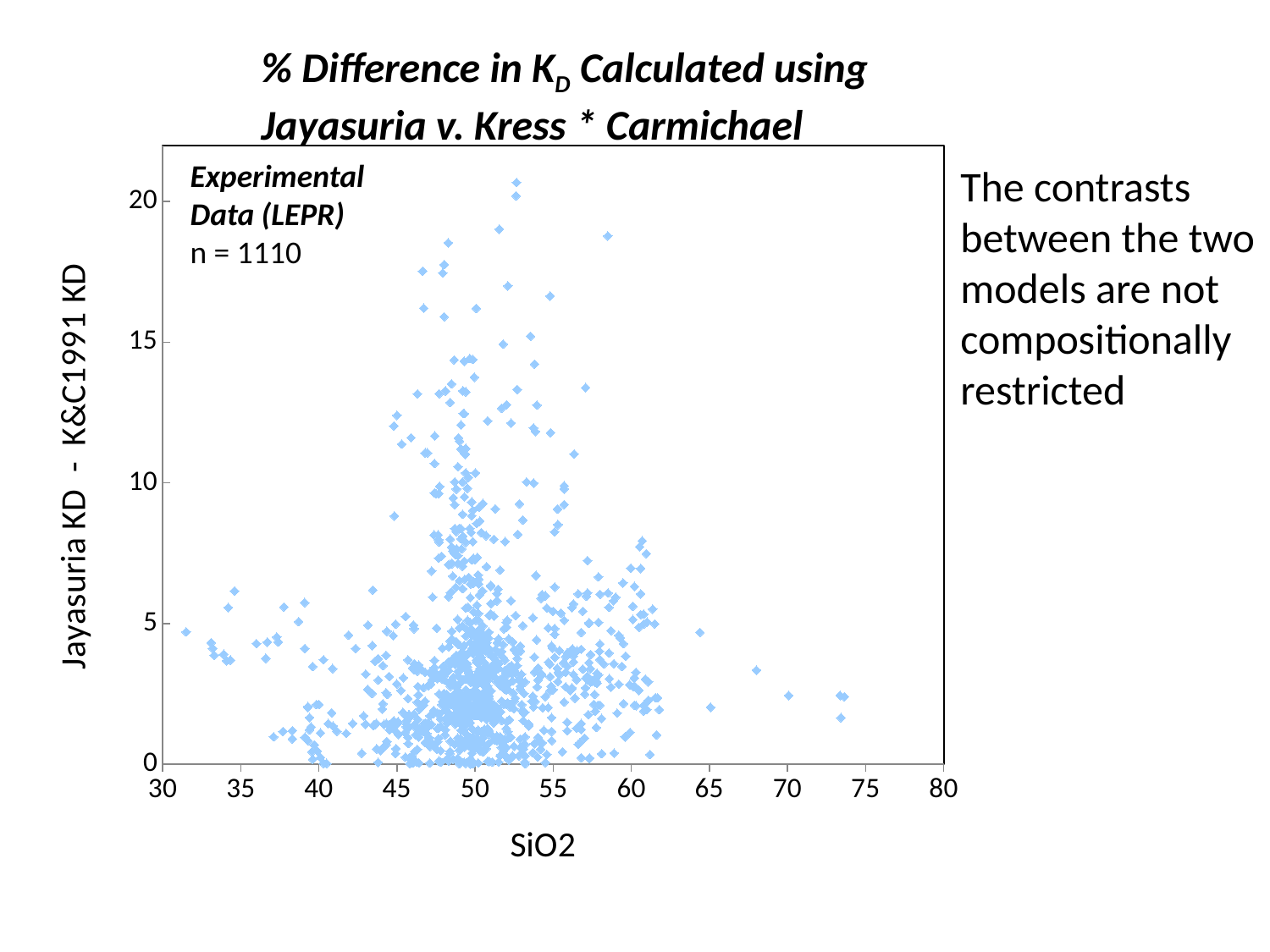
What is the label of the y axis? Jayasuria KD - K&C1991 KD What is the maximum value shown on the SiO2 axis? 80 Is the smallest SiO2 value among the plotted points greater or less than 35? less What is the highest tick value shown on the y axis? 20 What is the minimum value shown on the SiO2 axis? 30 What is the title of the chart? % Difference in KD Calculated using Jayasuria v. Kress * Carmichael What kind of chart is shown on the slide? scatter plot Is the largest SiO2 value among the plotted points greater or less than 70? greater What data source is named in the annotation inside the plot area? Experimental Data (LEPR) How many experimental data points does the chart state are plotted (n)? 1110 Is the largest SiO2 value among the plotted points greater or less than 75? less